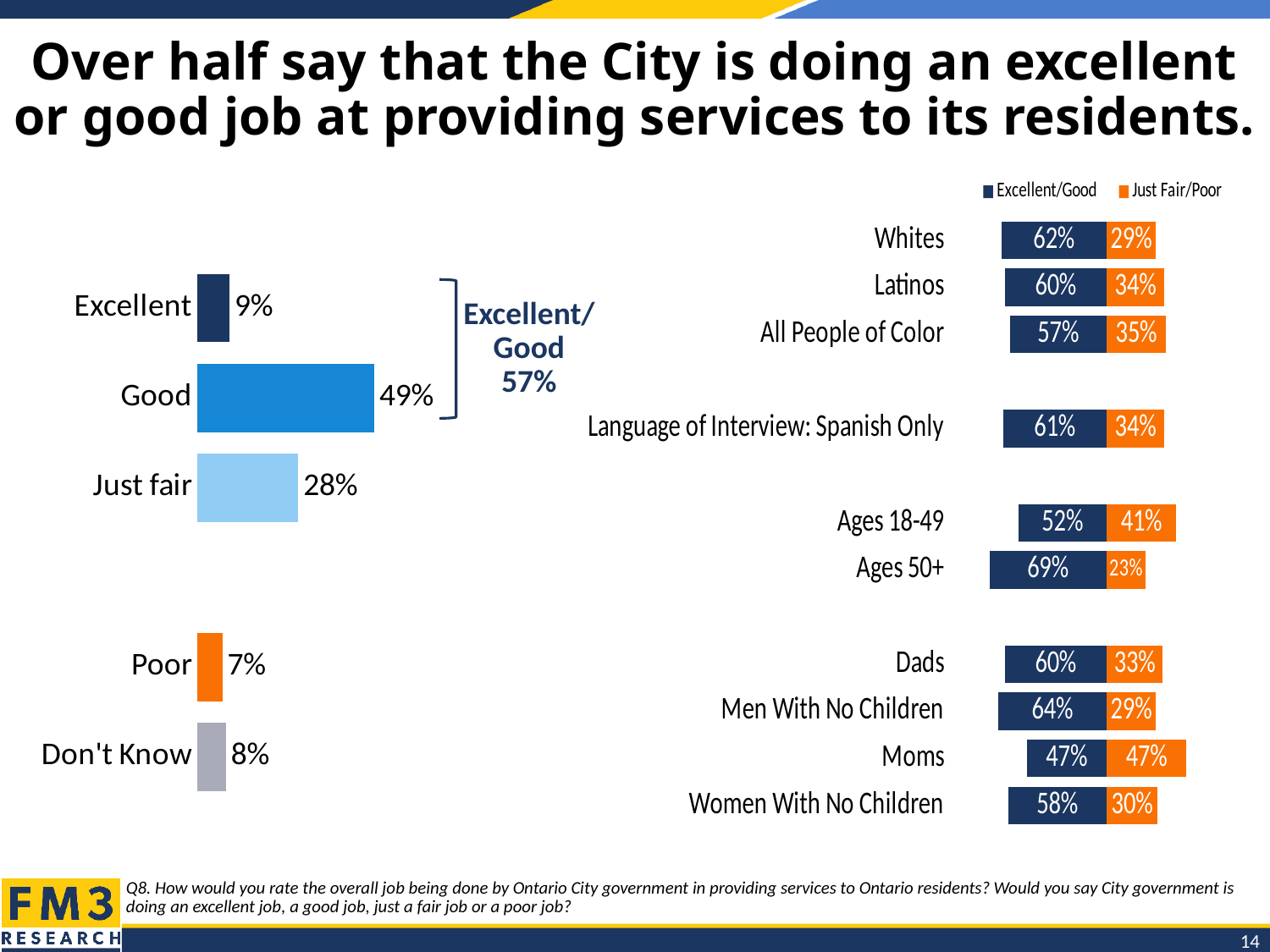
In the left chart, what percentage of respondents rated the City's job as Good? 49% In the left chart, which rating category has the highest value? Good In the left chart, what percentage of respondents said Don't Know? 8% In the right chart, how many series does the legend list? 2 In the right chart, what is the Just Fair/Poor percentage for Moms? 47% In the right chart, what is the Excellent/Good percentage for Ages 50+? 69% In the left chart, how many rating categories are shown? 5 In the left chart, what is the difference between the Good and Just fair percentages? 21% In the right chart, what is the combined total of Excellent/Good and Just Fair/Poor for Ages 18-49? 93% In the right chart, which group has the highest Excellent/Good percentage? Ages 50+ In the left chart, which rating category has the lowest value? Poor What type of chart is the left chart? Bar chart